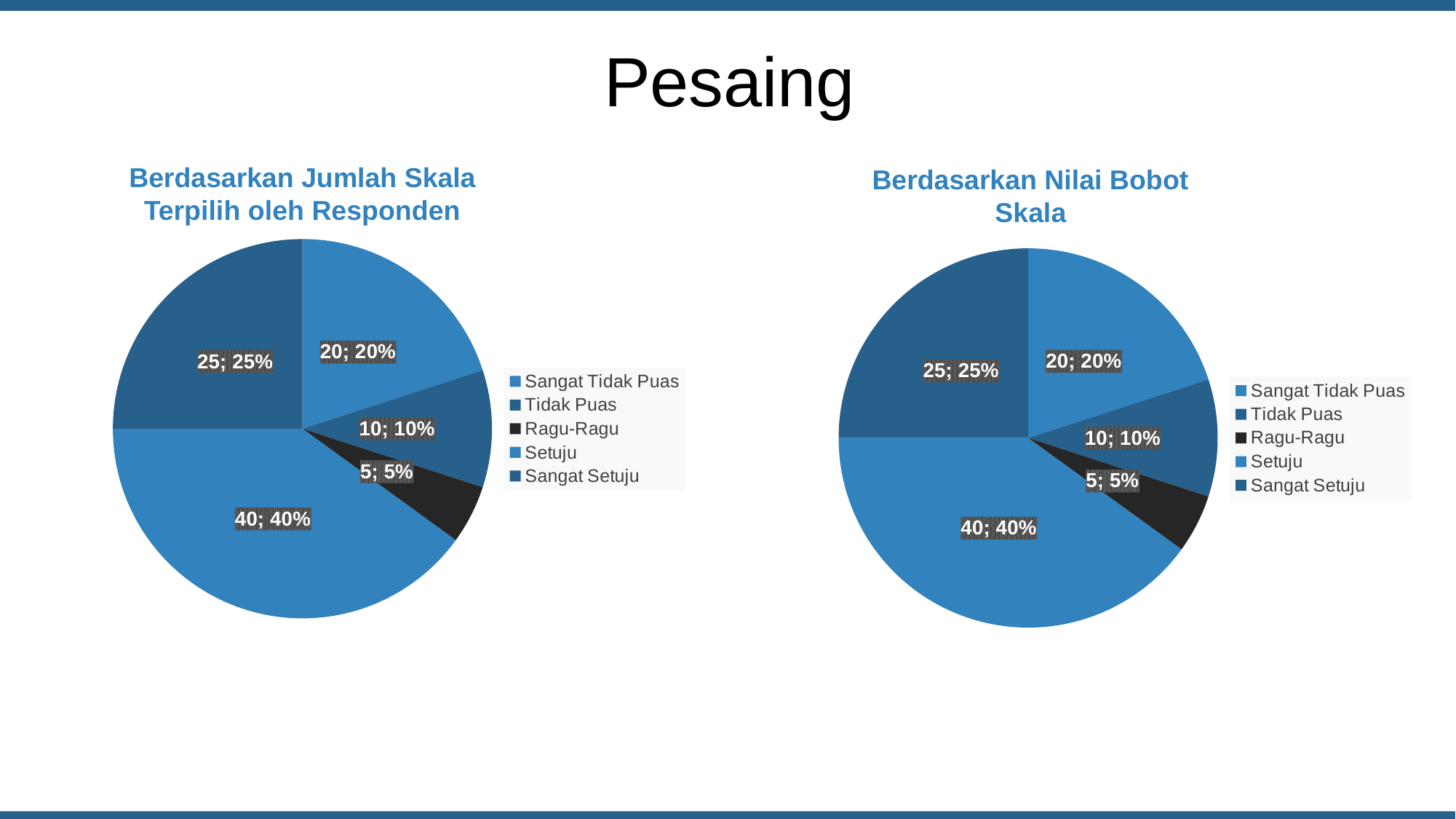
In the chart titled 'Berdasarkan Jumlah Skala Terpilih oleh Responden', what is the value for Ragu-Ragu? 5 In the chart titled 'Berdasarkan Nilai Bobot Skala', which category has the smallest slice? Ragu-Ragu In the chart titled 'Berdasarkan Nilai Bobot Skala', which category is shown in black? Ragu-Ragu In the chart titled 'Berdasarkan Jumlah Skala Terpilih oleh Responden', which is larger: Sangat Setuju or Sangat Tidak Puas? Sangat Setuju In the chart titled 'Berdasarkan Nilai Bobot Skala', what is the value for Sangat Tidak Puas? 20 In the chart titled 'Berdasarkan Jumlah Skala Terpilih oleh Responden', what is the total of the values for Tidak Puas and Ragu-Ragu? 15 In the chart titled 'Berdasarkan Jumlah Skala Terpilih oleh Responden', which category has the largest slice? Setuju What type of chart is the chart titled 'Berdasarkan Jumlah Skala Terpilih oleh Responden'? pie chart In the chart titled 'Berdasarkan Jumlah Skala Terpilih oleh Responden', what share of the pie is Setuju? 40% How many categories does the legend of the chart titled 'Berdasarkan Nilai Bobot Skala' list? 5 In the chart titled 'Berdasarkan Nilai Bobot Skala', what share of the pie is Sangat Setuju? 25% In the chart titled 'Berdasarkan Nilai Bobot Skala', what is the difference between the values for Setuju and Tidak Puas? 30